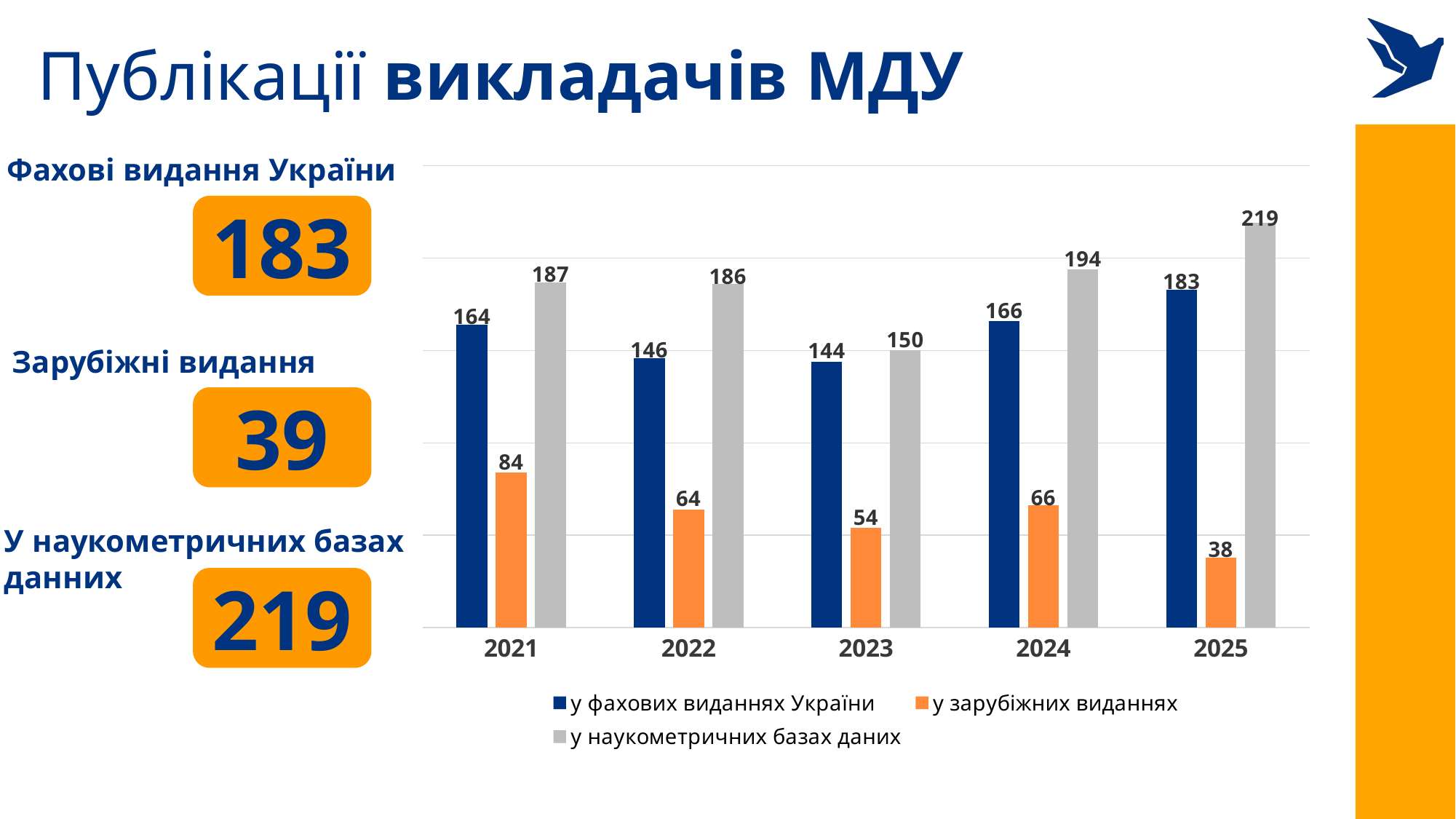
Which is larger in 2022: 'у фахових виданнях України' or 'у зарубіжних виданнях'? у фахових виданнях України How many series does the legend list? 3 Does the value for 'у зарубіжних виданнях' rise or fall from 2024 to 2025? fall What kind of chart is shown on the slide? bar chart What is the value for 'у наукометричних базах даних' in 2023? 150 How many years are shown on the x axis? 5 Which colour represents 'у наукометричних базах даних' in the chart? grey What is the value for 'у фахових виданнях України' in 2021? 164 In which year is the value for 'у зарубіжних виданнях' lowest? 2025 What is the value for 'у зарубіжних виданнях' in 2025? 38 What is the difference between the 'у наукометричних базах даних' values for 2025 and 2024? 25 In which year is the value for 'у наукометричних базах даних' highest? 2025